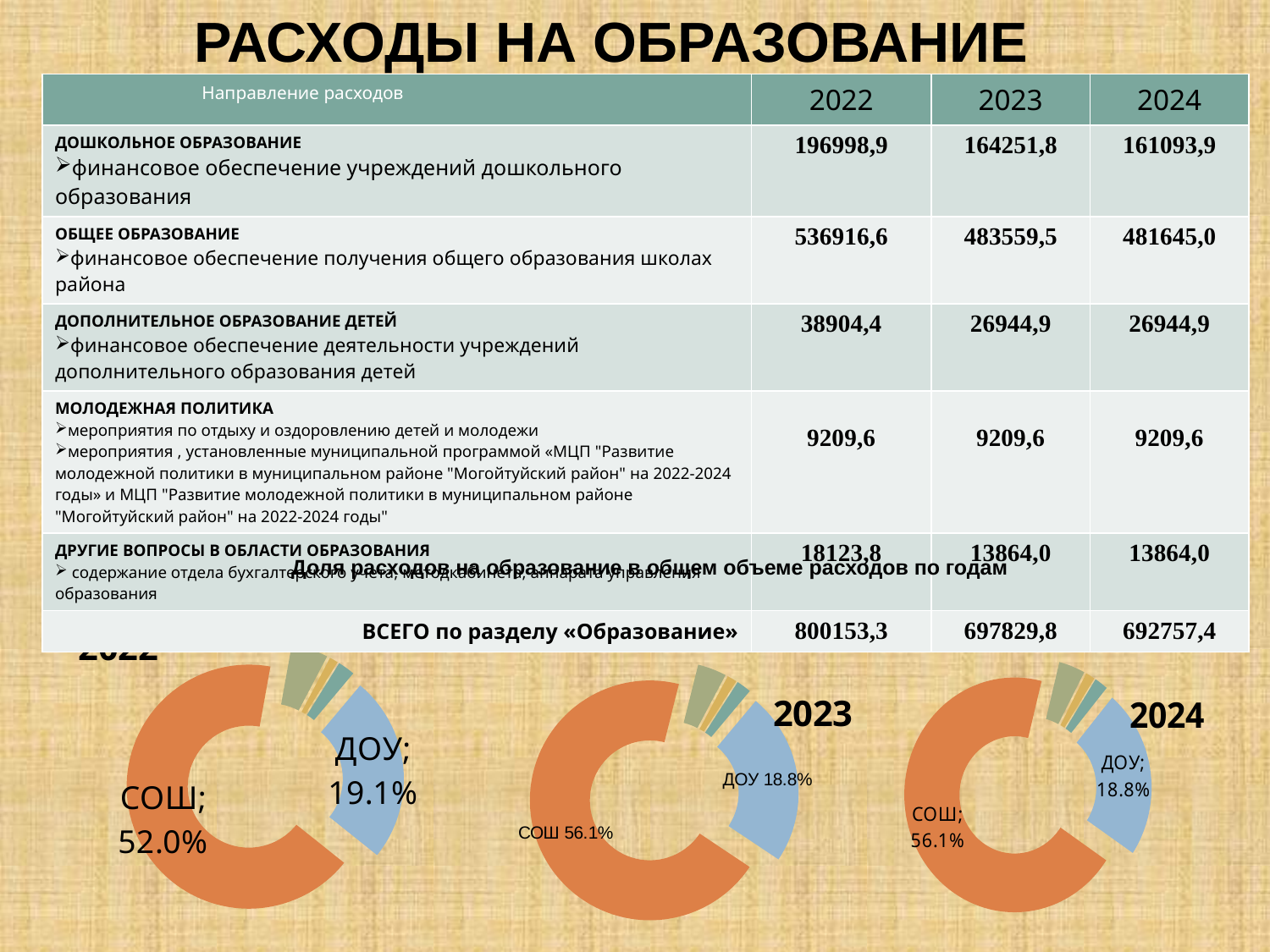
What kind of chart is used to show the share of education expenses by year? Doughnut (pie) chart In the 2024 chart, what share is shown for СОШ? 56.1% In the 2023 chart, what share is shown for СОШ? 56.1% In the 2023 chart, what share is shown for ДОУ? 18.8% How many doughnut charts are shown on the slide? 3 In the 2023 chart, what is the difference between the СОШ share and the ДОУ share? 37.3 percentage points In the 2024 chart, which labelled slice is the largest? СОШ In the 2022 chart, what share is shown for СОШ? 52.0% In the 2024 chart, what share is shown for ДОУ? 18.8% In the 2022 chart, what share is shown for ДОУ? 19.1% In the 2022 chart, what is the difference between the СОШ share and the ДОУ share? 32.9 percentage points In the 2022 chart, which labelled slice is larger, СОШ or ДОУ? СОШ